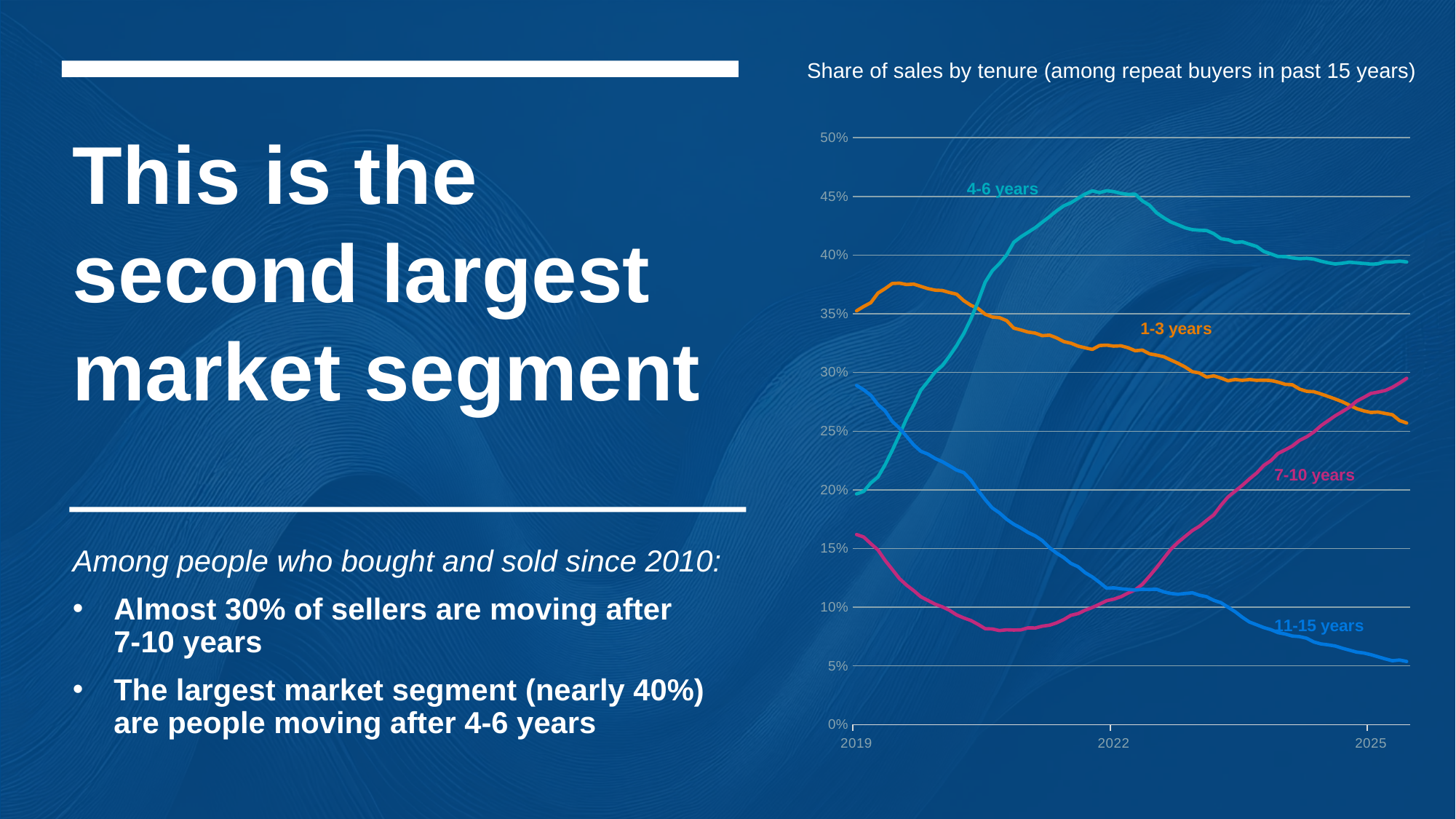
Is the share for 11-15 years at the start of the chart (2019) greater or less than 25%? greater Is the share for 4-6 years at the end of the chart greater or less than 35%? greater Is the share for 7-10 years at the start of the chart (2019) greater or less than 20%? less What is the title of the chart? Share of sales by tenure (among repeat buyers in past 15 years) Does the share for 7-10 years rise or fall from 2022 to 2025? rise What kind of chart is shown on the slide? Line chart Which tenure series has the lowest share of sales at the end of the chart (2025)? 11-15 years Which tenure series has the highest share of sales at the start of the chart (2019)? 1-3 years How many tenure series are plotted on the chart? 4 At the end of the chart, which is larger: the share for 4-6 years or the share for 1-3 years? 4-6 years Does the share for 11-15 years rise or fall from 2019 to 2025? fall Which tenure series has the highest share of sales at the end of the chart (2025)? 4-6 years